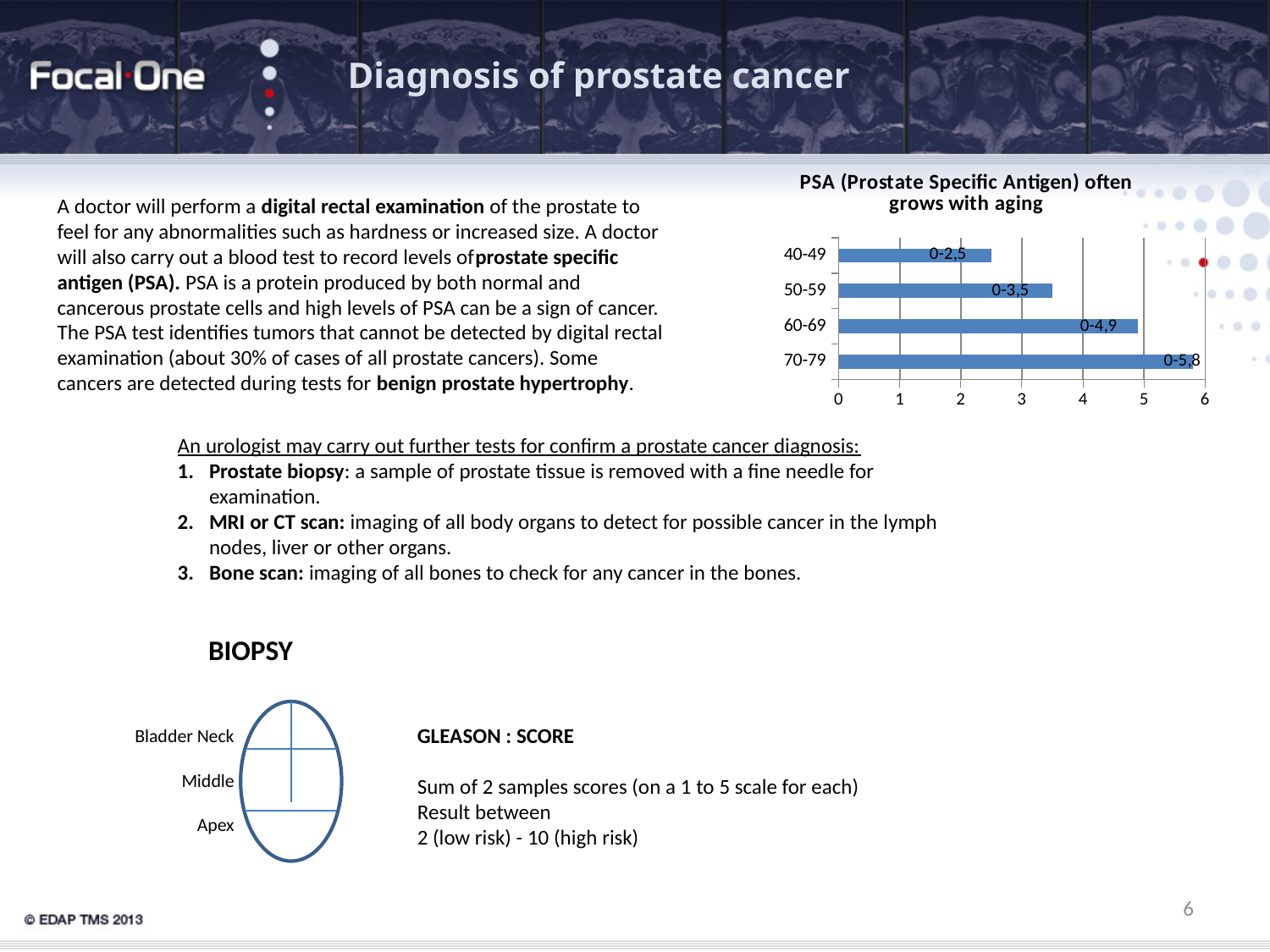
What data label is shown on the bar for the 40-49 age group? 0-2,5 What kind of chart is used to show PSA by age group? Bar chart By how much does the upper PSA value for the 70-79 group exceed the upper PSA value for the 40-49 group? 3,3 What data label is shown on the bar for the 70-79 age group? 0-5,8 Is the bar for the 60-69 age group greater or less than 4 on the axis? greater Which age group has the longest bar in the PSA chart? 70-79 Which age group has the shortest bar in the PSA chart? 40-49 What data label is shown on the bar for the 60-69 age group? 0-4,9 What is the title of the chart on the slide? PSA (Prostate Specific Antigen) often grows with aging Which bar is longer in the PSA chart, 50-59 or 60-69? 60-69 How many age groups are shown in the PSA chart? 4 What data label is shown on the bar for the 50-59 age group? 0-3,5